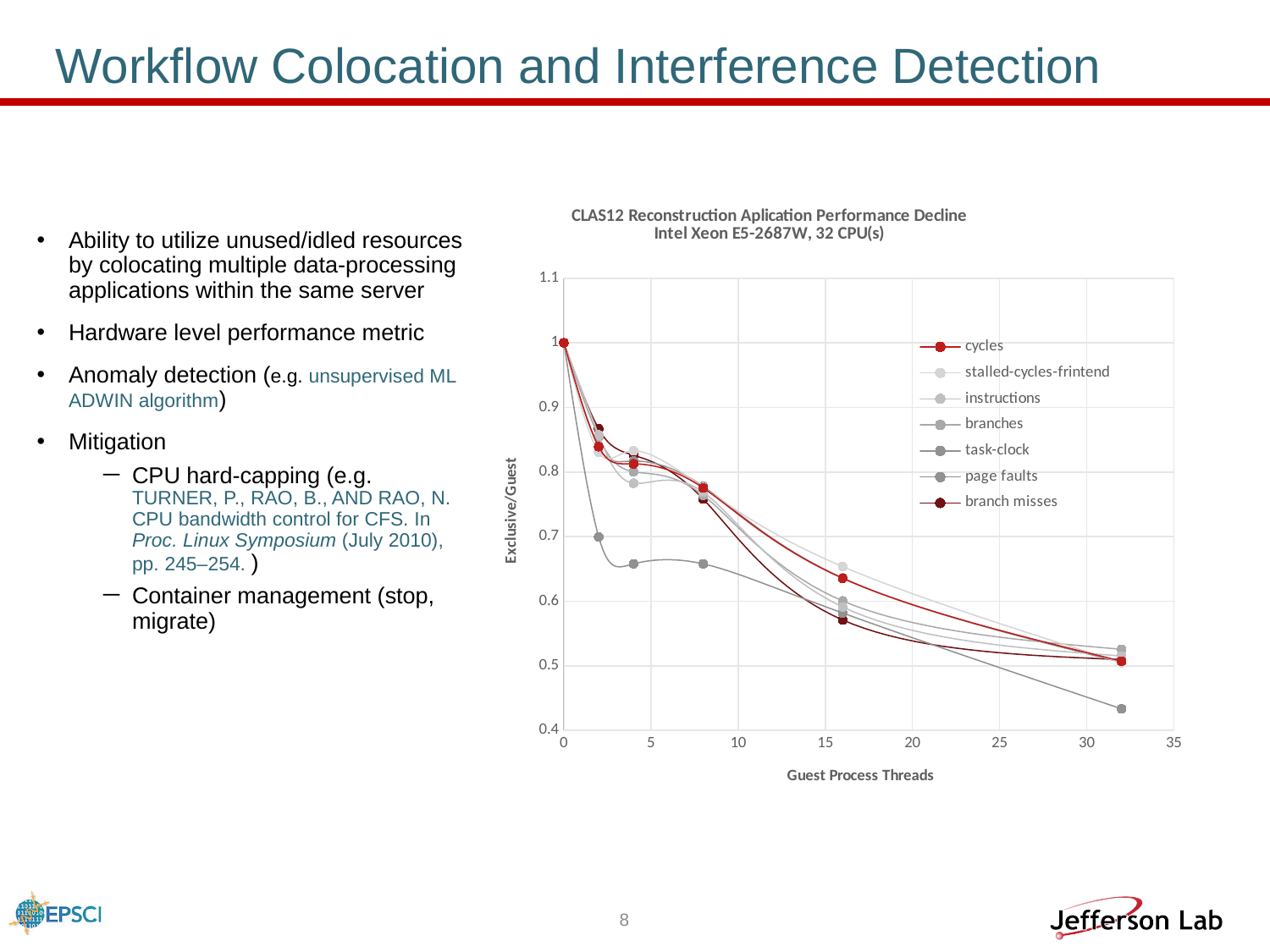
How many data points are plotted for the cycles series? 6 What kind of chart is shown on the slide? line chart Which series has the lowest value at 2 Guest Process Threads? page faults Do the values of the cycles series rise or fall as Guest Process Threads increase? fall Is the value of page faults at 32 Guest Process Threads greater or less than 0.5? less At 32 Guest Process Threads, which is larger: cycles or page faults? cycles What is the title of the chart? CLAS12 Reconstruction Aplication Performance Decline Intel Xeon E5-2687W, 32 CPU(s) What is the value of the cycles series at 0 Guest Process Threads? 1 Is the value of cycles at 16 Guest Process Threads greater or less than 0.6? greater Which series has the lowest value at 32 Guest Process Threads? page faults What is the label of the x axis? Guest Process Threads How many series does the legend list? 7